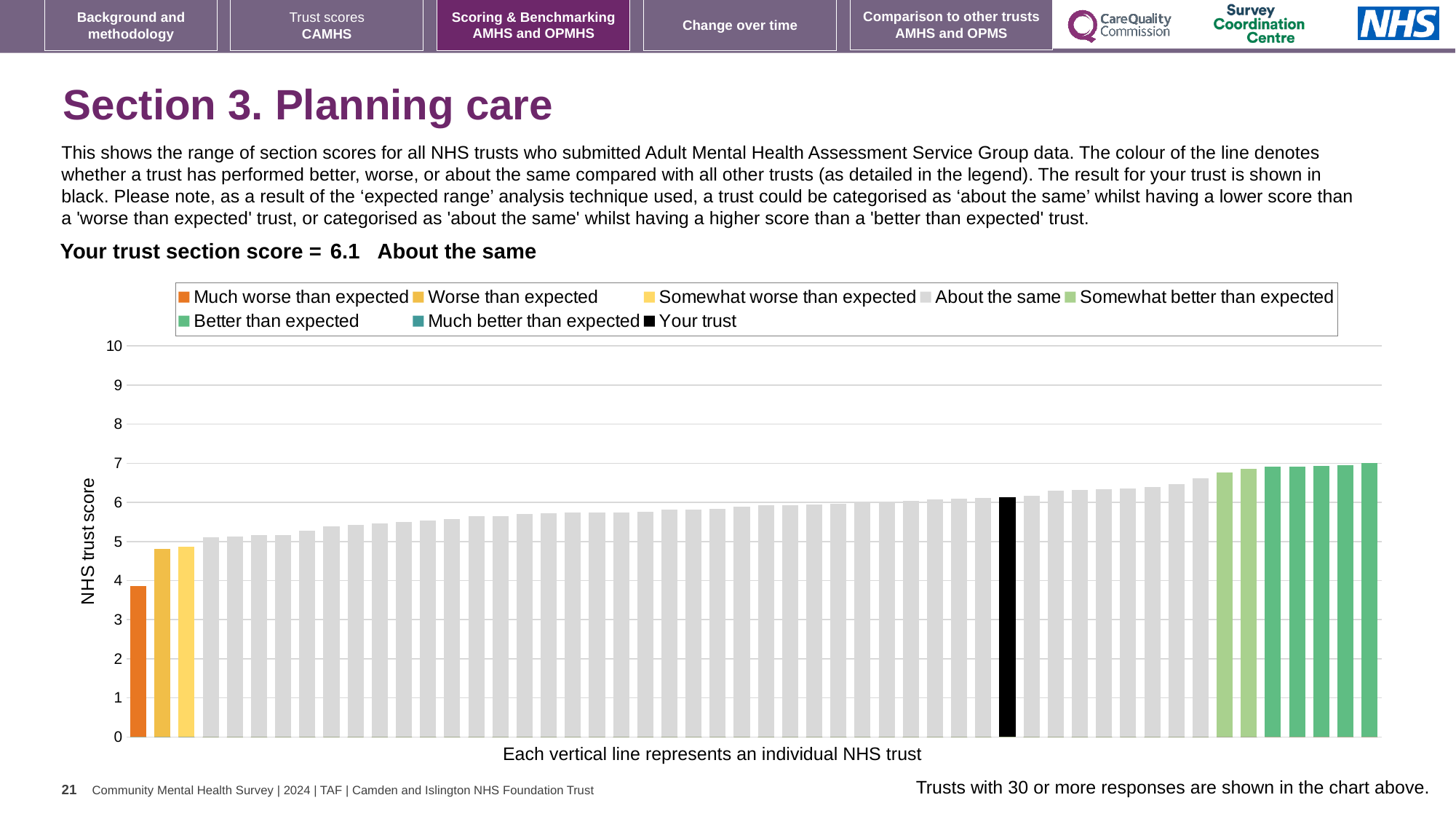
What is your trust's section score for Planning care? 6.1 Which category is your trust placed in for Planning care? About the same Is the value of the black 'Your trust' bar greater or less than 6? greater Is the value of the lowest bar (the orange 'Much worse than expected' trust) greater or less than 5? less How many entries does the chart legend list? 8 What is the label on the y axis of the chart? NHS trust score Which legend category does the lowest bar in the chart belong to? Much worse than expected Which legend category do the highest bars in the chart belong to? Better than expected Which is higher: the black 'Your trust' bar or the orange 'Much worse than expected' bar? Your trust What kind of chart is shown on the slide? Bar chart Do the bar values rise or fall from left to right along the x axis? Rise How many bars are coloured orange ('Much worse than expected')? 1